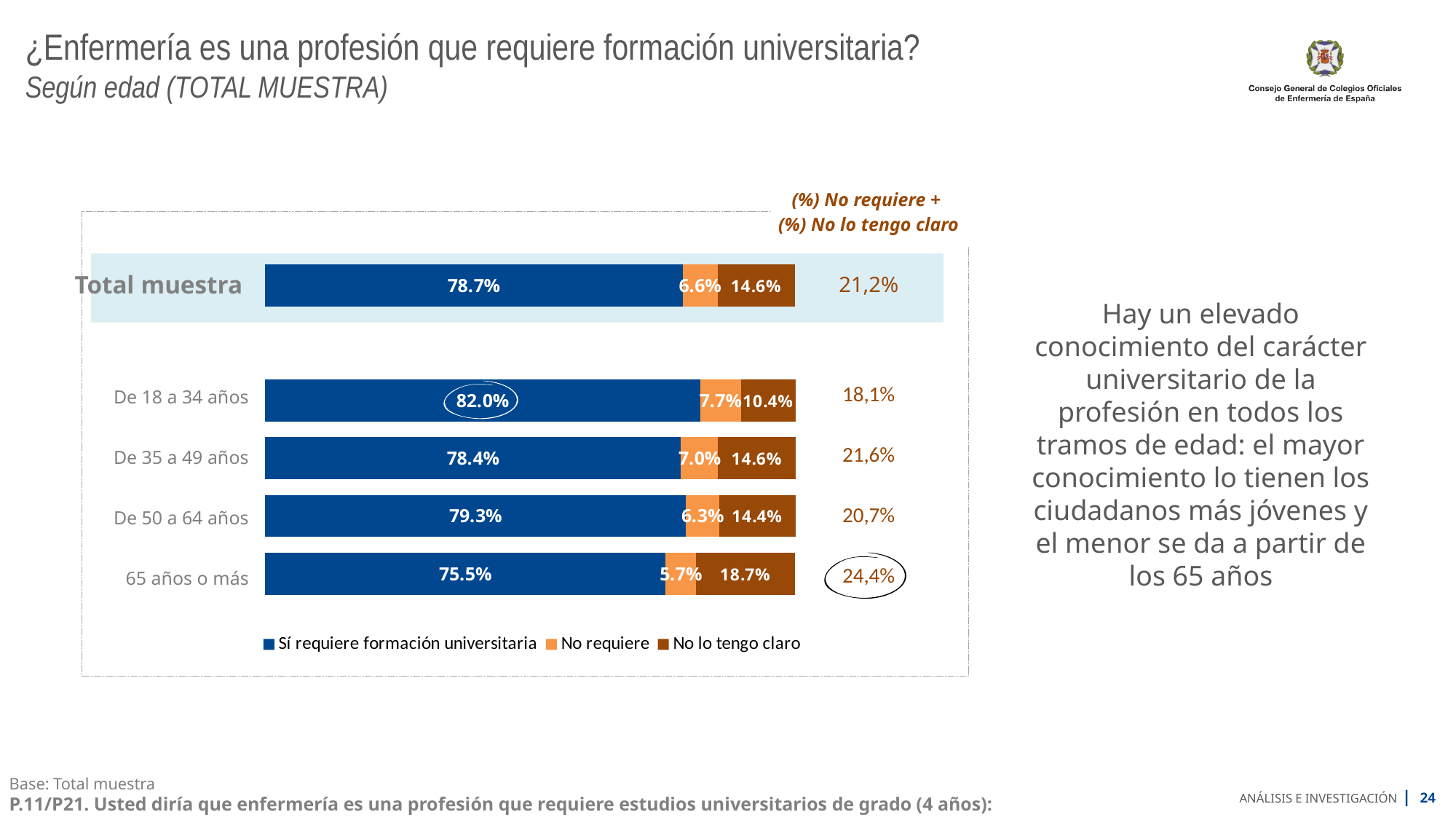
What is the combined '(%) No requiere + (%) No lo tengo claro' figure shown for the '65 años o más' group? 24,4% Which has a larger 'No requiere' value: 'De 35 a 49 años' or 'De 50 a 64 años'? De 35 a 49 años What percentage of the 'De 18 a 34 años' group answered 'Sí requiere formación universitaria'? 82.0% How many bars (categories) are shown in the chart, including 'Total muestra'? 5 What is the 'No lo tengo claro' value for the '65 años o más' group? 18.7% Which age group has the lowest 'Sí requiere formación universitaria' value? 65 años o más How many series does the legend list? 3 What is the difference in percentage points between the 'Sí requiere formación universitaria' values for 'De 18 a 34 años' and '65 años o más'? 6.5 percentage points What kind of chart is shown on the slide? Stacked horizontal bar chart Which age group has the highest 'Sí requiere formación universitaria' value? De 18 a 34 años What colour represents the 'Sí requiere formación universitaria' series? Dark blue What is the 'No requiere' value for 'Total muestra'? 6.6%